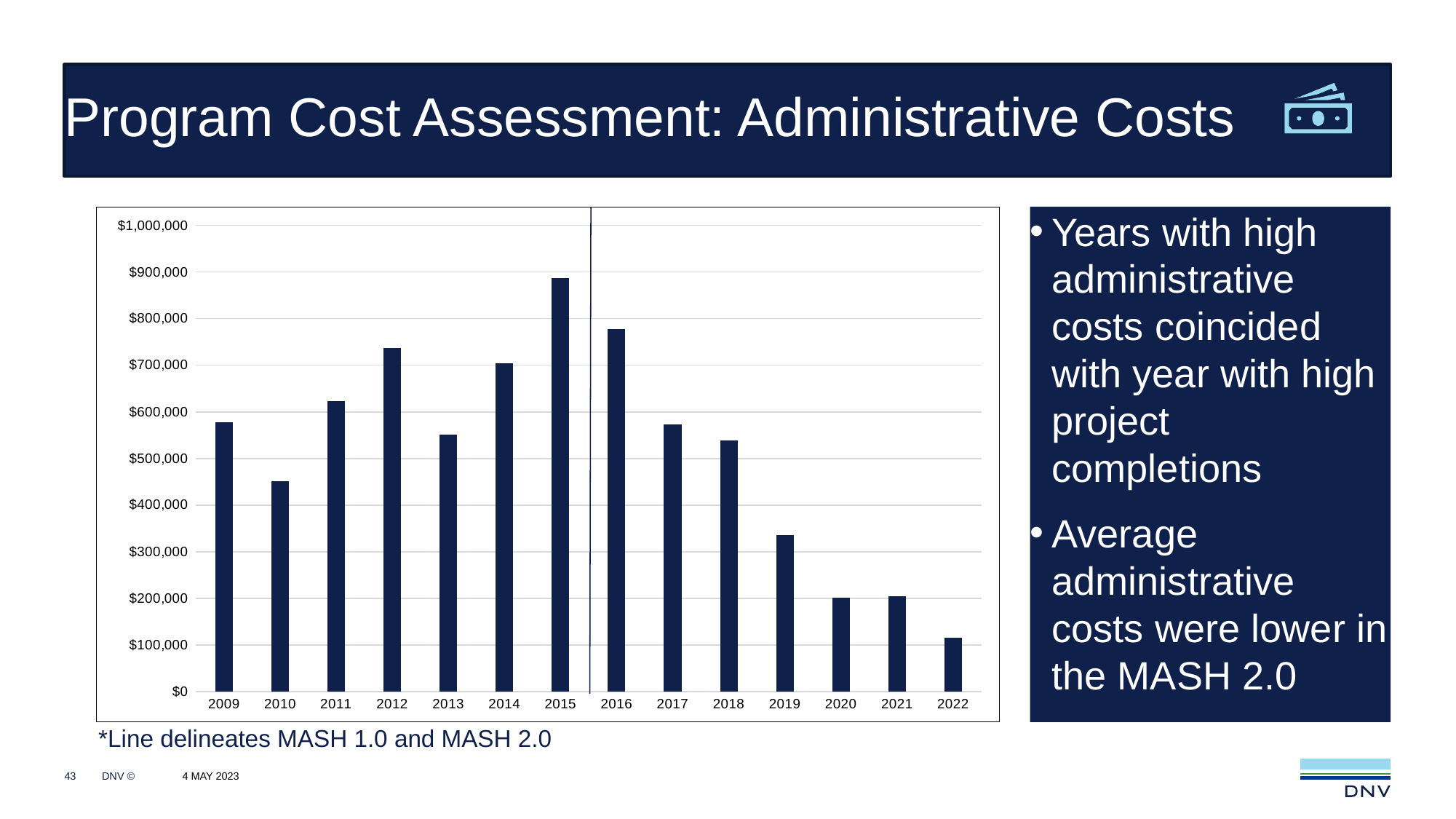
Which year has the larger administrative cost, 2012 or 2013? 2012 Is the value for 2015 greater or less than $800,000? greater Which year has the lowest administrative cost in the chart? 2022 Is the value for 2012 greater or less than $700,000? greater How many years are plotted on the x axis of the chart? 14 Which year has the highest administrative cost in the chart? 2015 Which year has the larger administrative cost, 2016 or 2017? 2016 Do the administrative costs rise or fall from 2016 to 2022? fall Is the value for 2019 greater or less than $400,000? less According to the note below the chart, what does the vertical line in the chart delineate? MASH 1.0 and MASH 2.0 What kind of chart is shown on the slide? bar chart